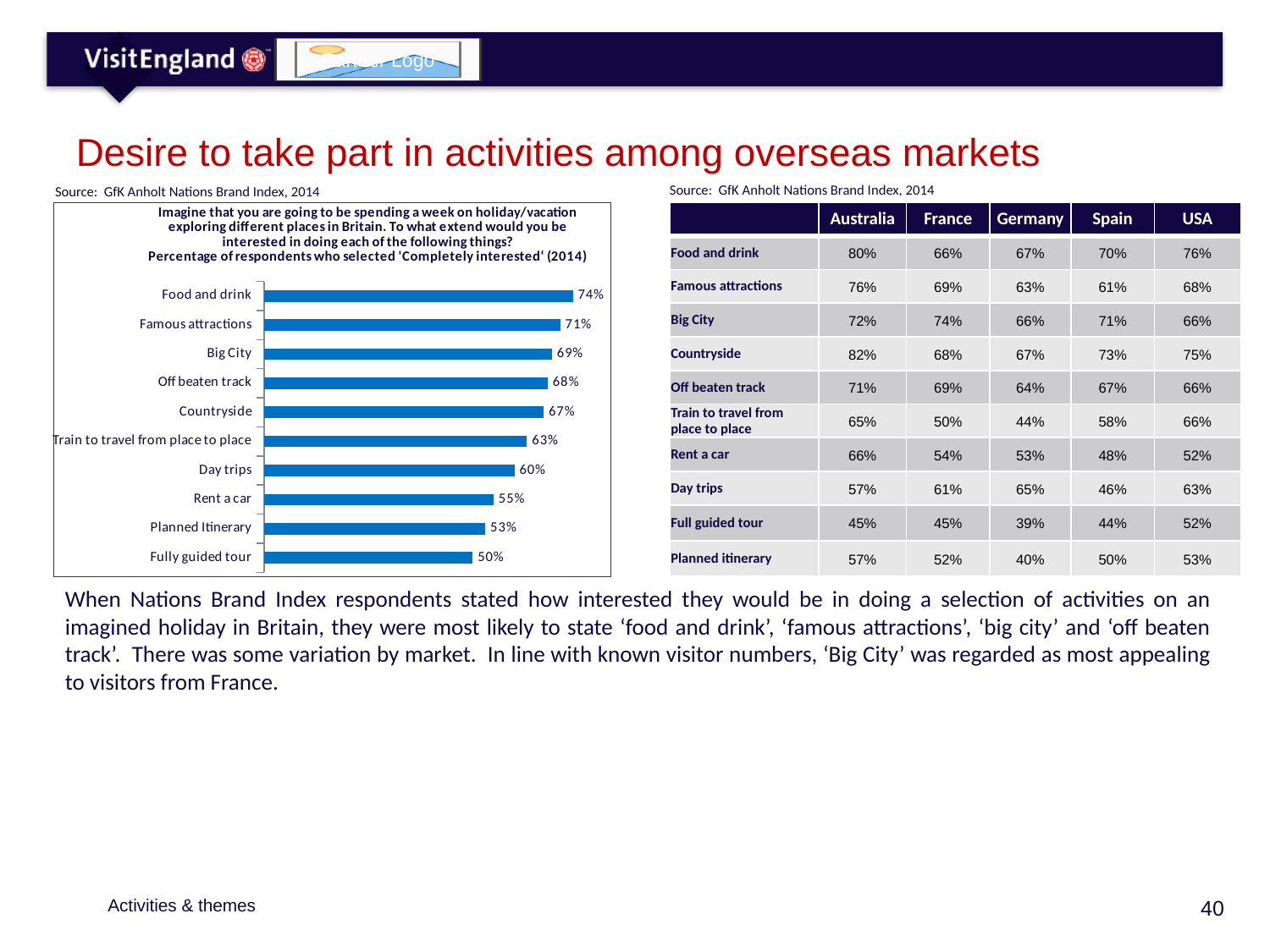
What is the difference between the values for Day trips and Planned Itinerary in the bar chart? 7% What type of chart is used to show the percentage of respondents who selected 'Completely interested'? Bar chart What percentage of respondents selected 'Completely interested' for Food and drink in the bar chart? 74% What is the value shown for Countryside in the bar chart? 67% In the bar chart, which has a higher value: Big City or Train to travel from place to place? Big City Which activity has the highest value in the bar chart? Food and drink What is the difference between the values for Food and drink and Fully guided tour in the bar chart? 24% What year is given in the bar chart's title for the data shown? 2014 Do the values in the bar chart increase or decrease from the top bar to the bottom bar? Decrease How many activities are shown in the bar chart? 10 Which activity has the lowest value in the bar chart? Fully guided tour What is the value shown for Rent a car in the bar chart? 55%